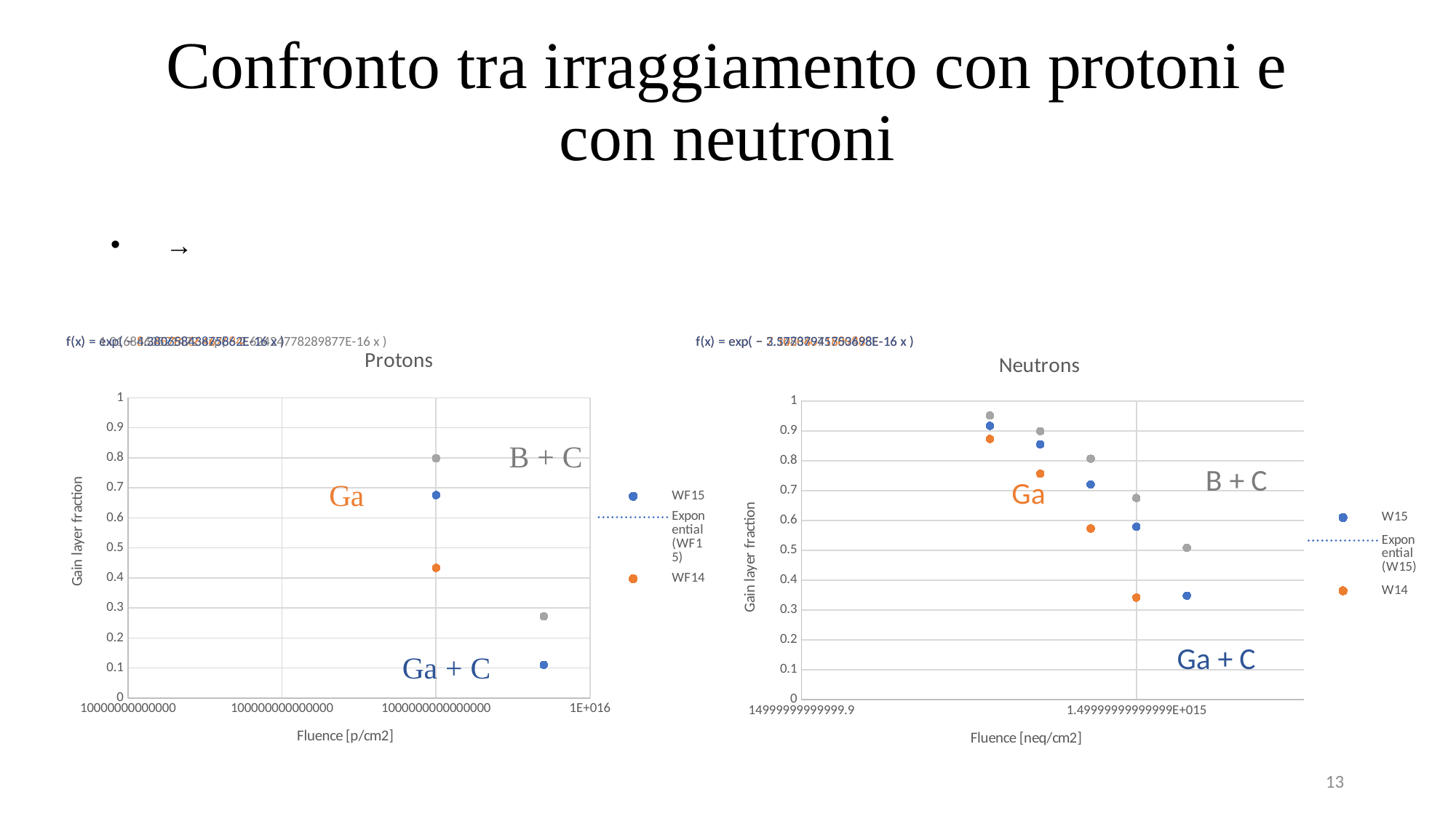
In the Neutrons chart, do the W15 values rise or fall as fluence increases along the x axis? fall In the Neutrons chart, is the lowest W14 point greater or less than 0.4? less In the Neutrons chart, is the highest W15 point greater or less than 0.8? greater How many series does the legend of the Neutrons chart list? 3 How many series does the legend of the Protons chart list? 3 In the Neutrons chart, at the leftmost fluence, which is higher, the W15 point or the W14 point? W15 In the Protons chart, at the fluence of 1000000000000000 p/cm2, which is higher, the WF15 point or the WF14 point? WF15 What kind of chart is the Protons chart? scatter chart In the Protons chart, is the lowest WF15 point greater or less than 0.2? less What is the x-axis title of the Neutrons chart? Fluence [neq/cm2] How many W14 points are plotted in the Neutrons chart? 4